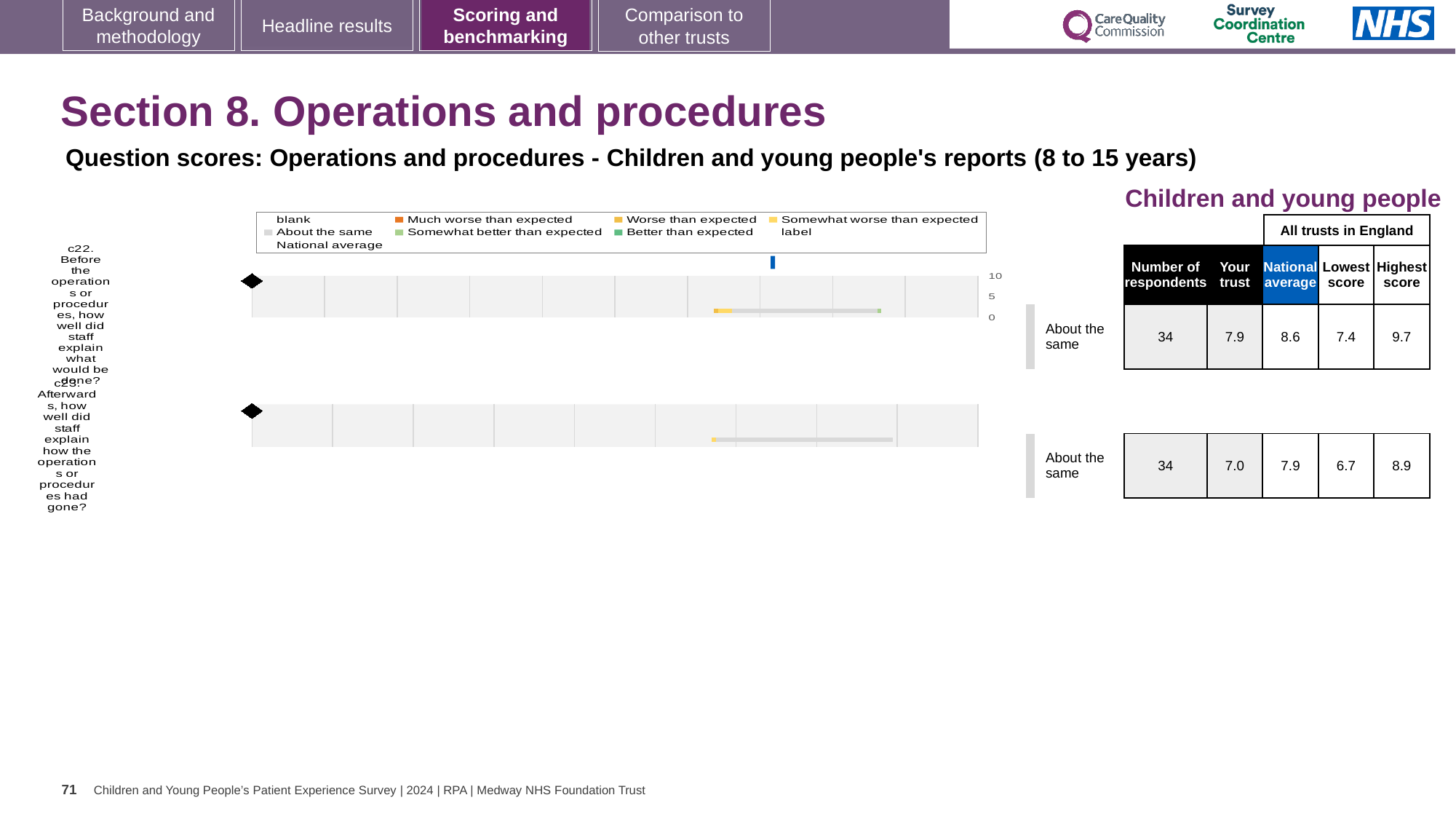
In the table beside the chart, how many respondents answered c22? 34 How many questions (categories) are plotted in the chart? 2 In the table beside the chart, what is the Highest score for c22? 9.7 Which question has the higher 'Your trust' score in the table beside the chart, c22 or c23? c22 In the table beside the chart, what is the National average for c23 (Afterwards, how well did staff explain how the operations or procedures had gone?)? 7.9 What benchmark category is shown next to both c22 and c23 in the chart? About the same What kind of chart is shown on the slide? bar chart What is the difference between the National average and the 'Your trust' score for c22 in the table beside the chart? 0.7 What is the highest tick value shown on the chart's axis? 10 In the table beside the chart, what is the Lowest score for c23? 6.7 How many entries does the chart legend list? 9 In the table beside the chart, what is the 'Your trust' score for c22 (Before the operations or procedures, how well did staff explain what would be done?)? 7.9